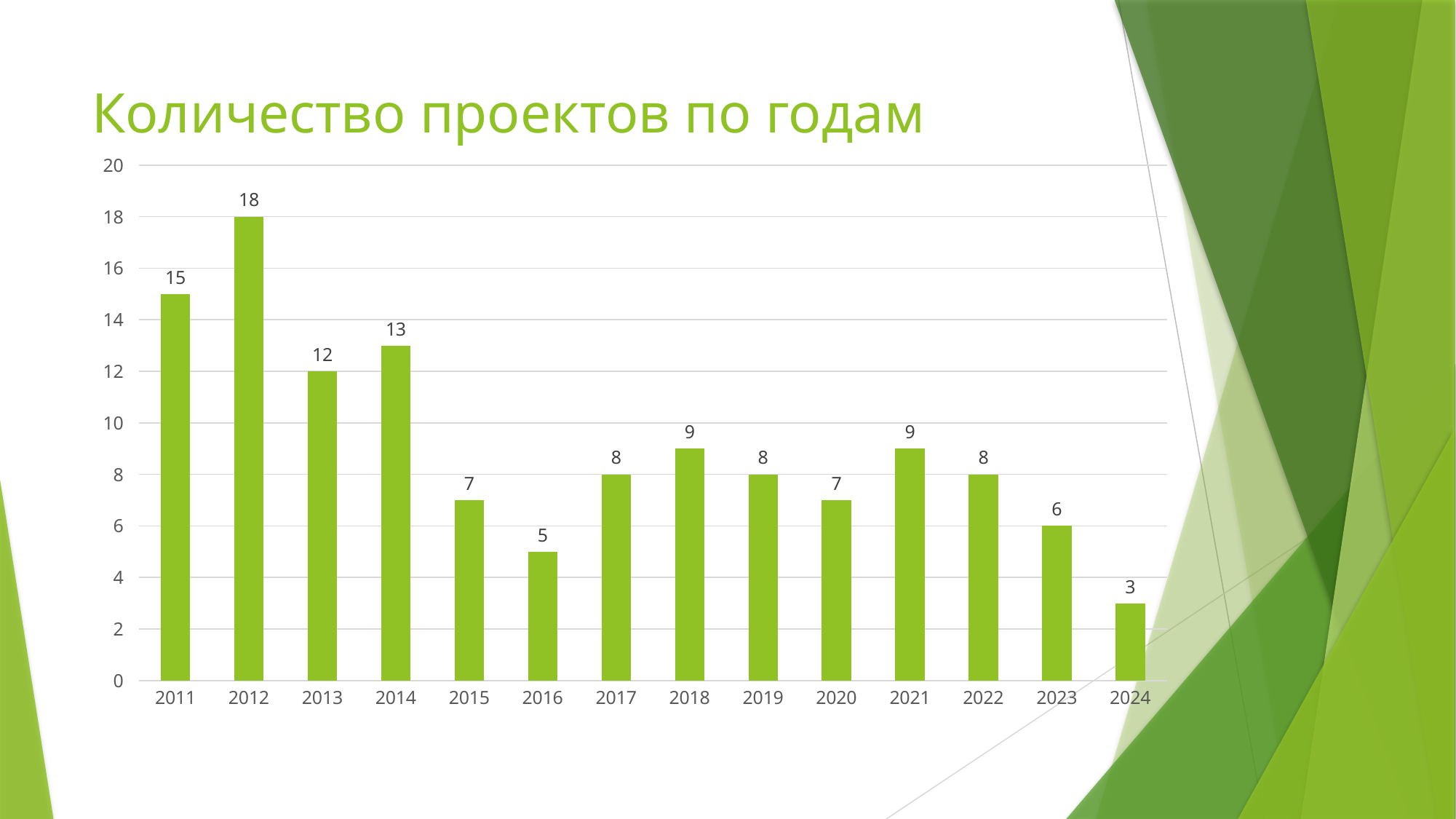
What kind of chart is shown on the slide? Bar chart What is the difference between the values for 2014 and 2015? 6 Which is larger, the value for 2013 or the value for 2018? 2013 What is the value for 2016? 5 What is the value for 2012? 18 Which year has the highest value? 2012 What is the value for 2024? 3 What is the title of the chart? Количество проектов по годам Is the value for 2011 greater or less than 14? greater Which year has the lowest value? 2024 What is the difference between the values for 2012 and 2011? 3 How many years are shown on the x axis? 14